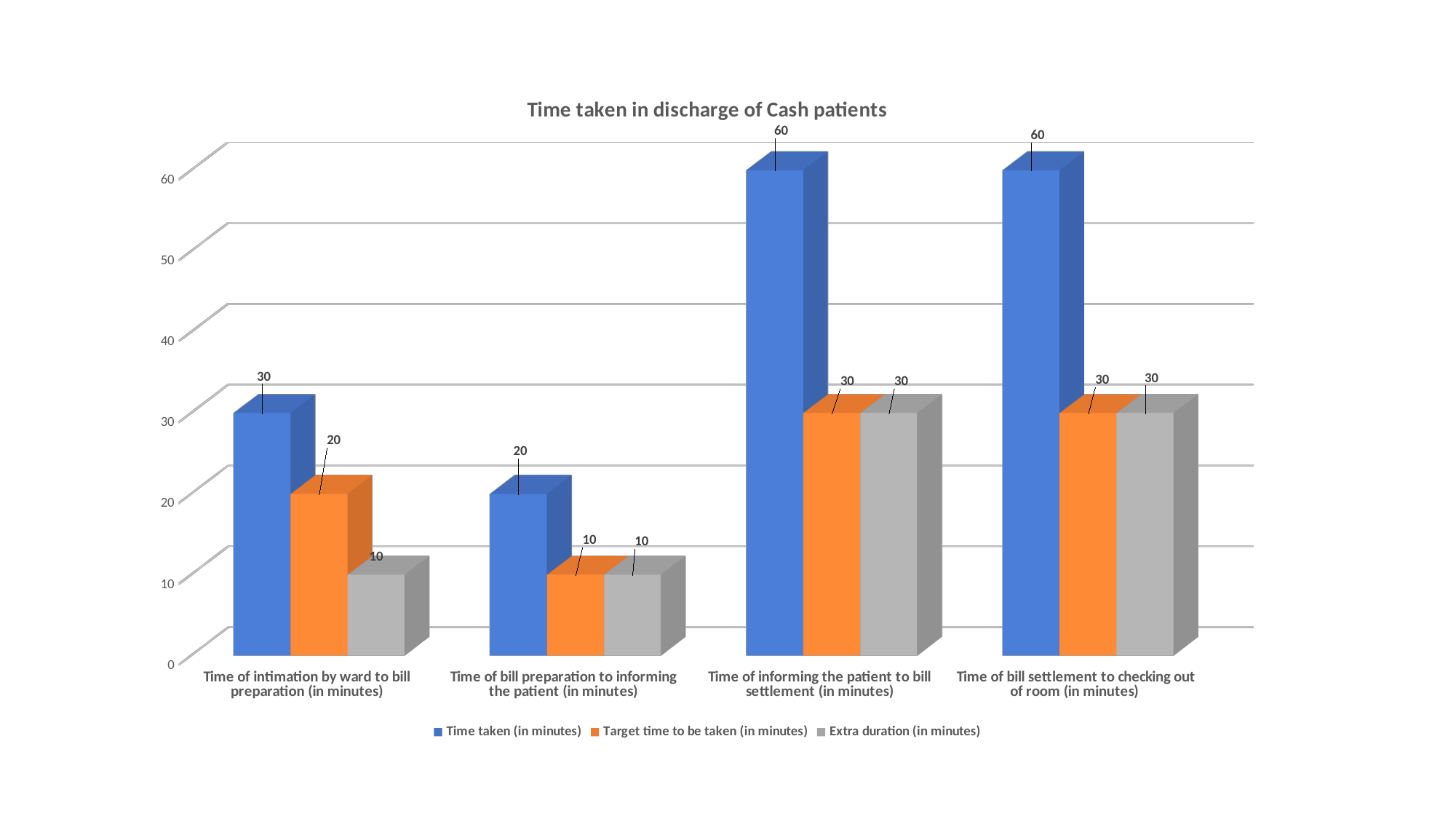
What is the 'Time taken (in minutes)' value for 'Time of intimation by ward to bill preparation (in minutes)'? 30 What is the 'Time taken (in minutes)' value for 'Time of bill settlement to checking out of room (in minutes)'? 60 What is the 'Target time to be taken (in minutes)' value for 'Time of bill preparation to informing the patient (in minutes)'? 10 Which is larger for 'Time of intimation by ward to bill preparation (in minutes)': 'Target time to be taken (in minutes)' or 'Extra duration (in minutes)'? Target time to be taken (in minutes) What is the difference between 'Time taken (in minutes)' and 'Target time to be taken (in minutes)' for 'Time of informing the patient to bill settlement (in minutes)'? 30 What is the 'Extra duration (in minutes)' value for 'Time of bill settlement to checking out of room (in minutes)'? 30 What kind of chart is shown on the slide? Bar chart What is the title of the chart? Time taken in discharge of Cash patients Which colour represents the 'Extra duration (in minutes)' series? Grey How many series does the legend list? 3 How many categories are shown on the x axis? 4 Which category has the lowest 'Time taken (in minutes)' value? Time of bill preparation to informing the patient (in minutes)